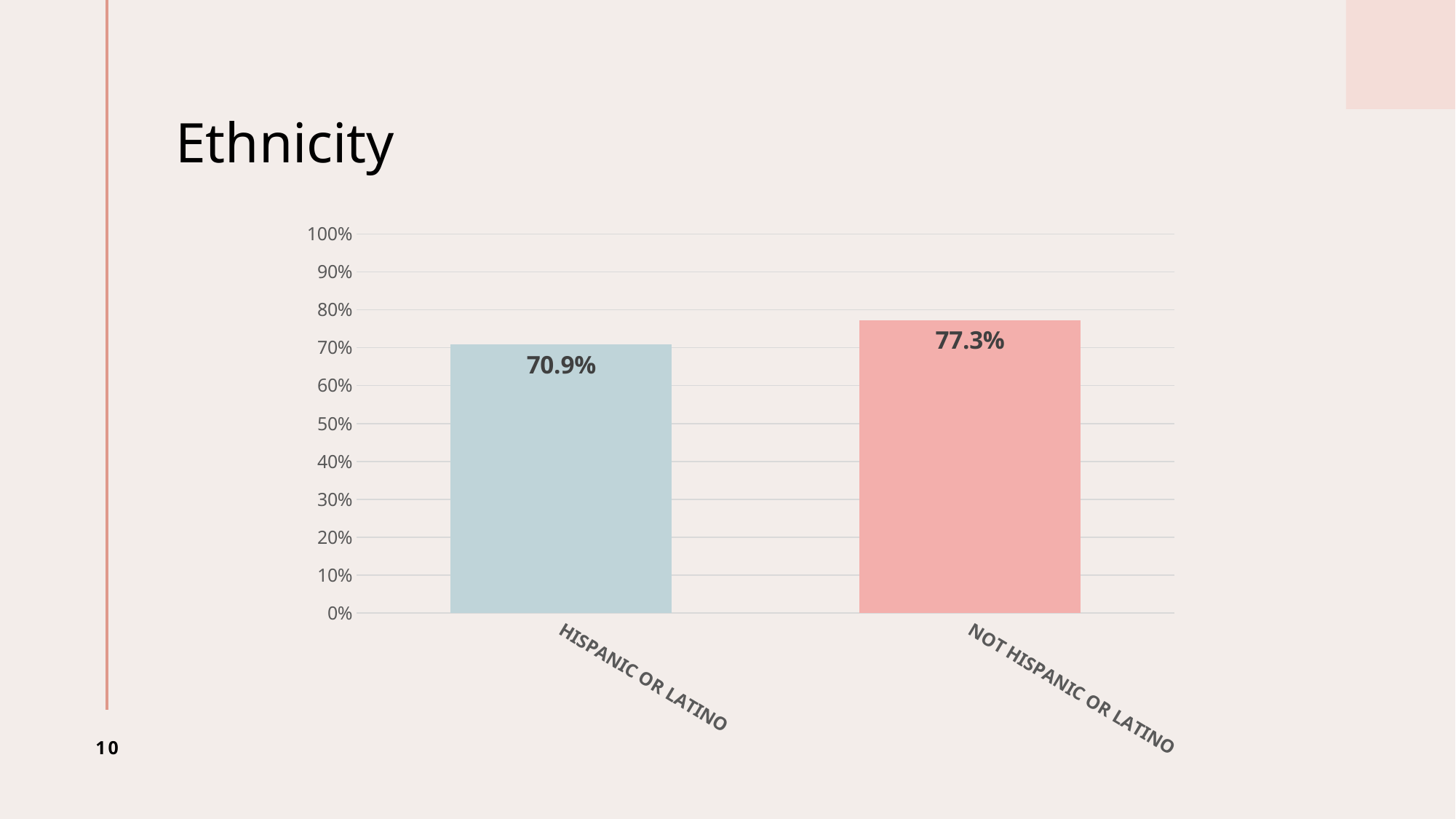
Is the value for Not Hispanic or Latino greater or less than 70%? greater What is the highest value shown on the vertical axis? 100% Is the value for Hispanic or Latino greater or less than 80%? less How many categories are shown on the chart? 2 Which category has the lowest value? Hispanic or Latino Which category has the highest value? Not Hispanic or Latino What is the title of the slide? Ethnicity What kind of chart is shown on the slide? Bar chart Which is larger, the value for Hispanic or Latino or the value for Not Hispanic or Latino? Not Hispanic or Latino What is the value for Hispanic or Latino? 70.9% What is the difference between the values for Not Hispanic or Latino and Hispanic or Latino? 6.4% What is the value for Not Hispanic or Latino? 77.3%